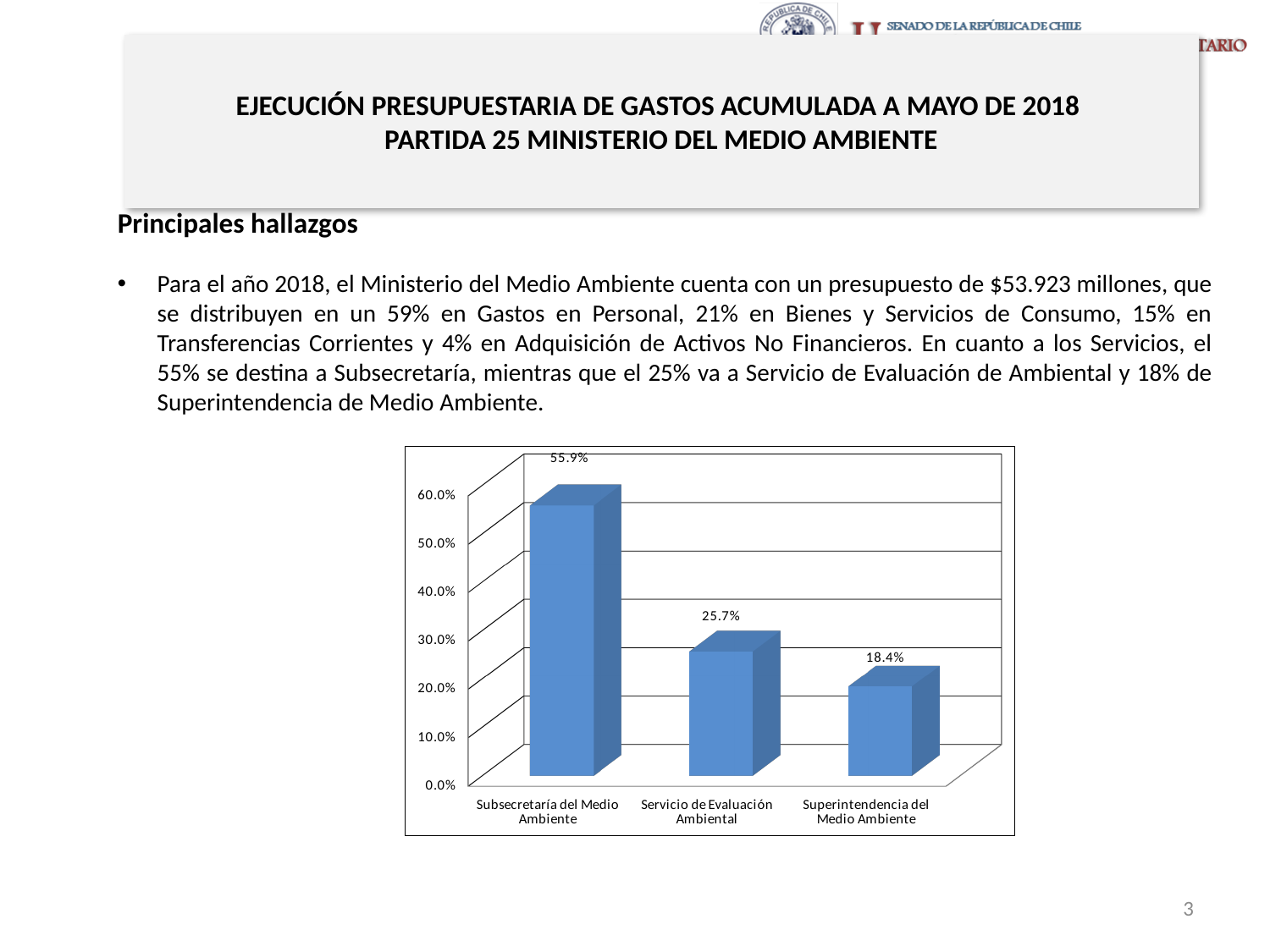
What is the difference between the values for Subsecretaría del Medio Ambiente and Servicio de Evaluación Ambiental? 30.2% Which category has the highest value? Subsecretaría del Medio Ambiente Do the values rise or fall from left to right along the x axis? Fall How many categories are shown in the chart? 3 What is the value for Servicio de Evaluación Ambiental? 25.7% Is the value for Subsecretaría del Medio Ambiente greater or less than 50.0%? greater What is the value for Superintendencia del Medio Ambiente? 18.4% Which is larger, the value for Servicio de Evaluación Ambiental or Superintendencia del Medio Ambiente? Servicio de Evaluación Ambiental What kind of chart is shown on the slide? Bar chart What is the difference between the values for Servicio de Evaluación Ambiental and Superintendencia del Medio Ambiente? 7.3% What is the value for Subsecretaría del Medio Ambiente? 55.9% Which category has the lowest value? Superintendencia del Medio Ambiente